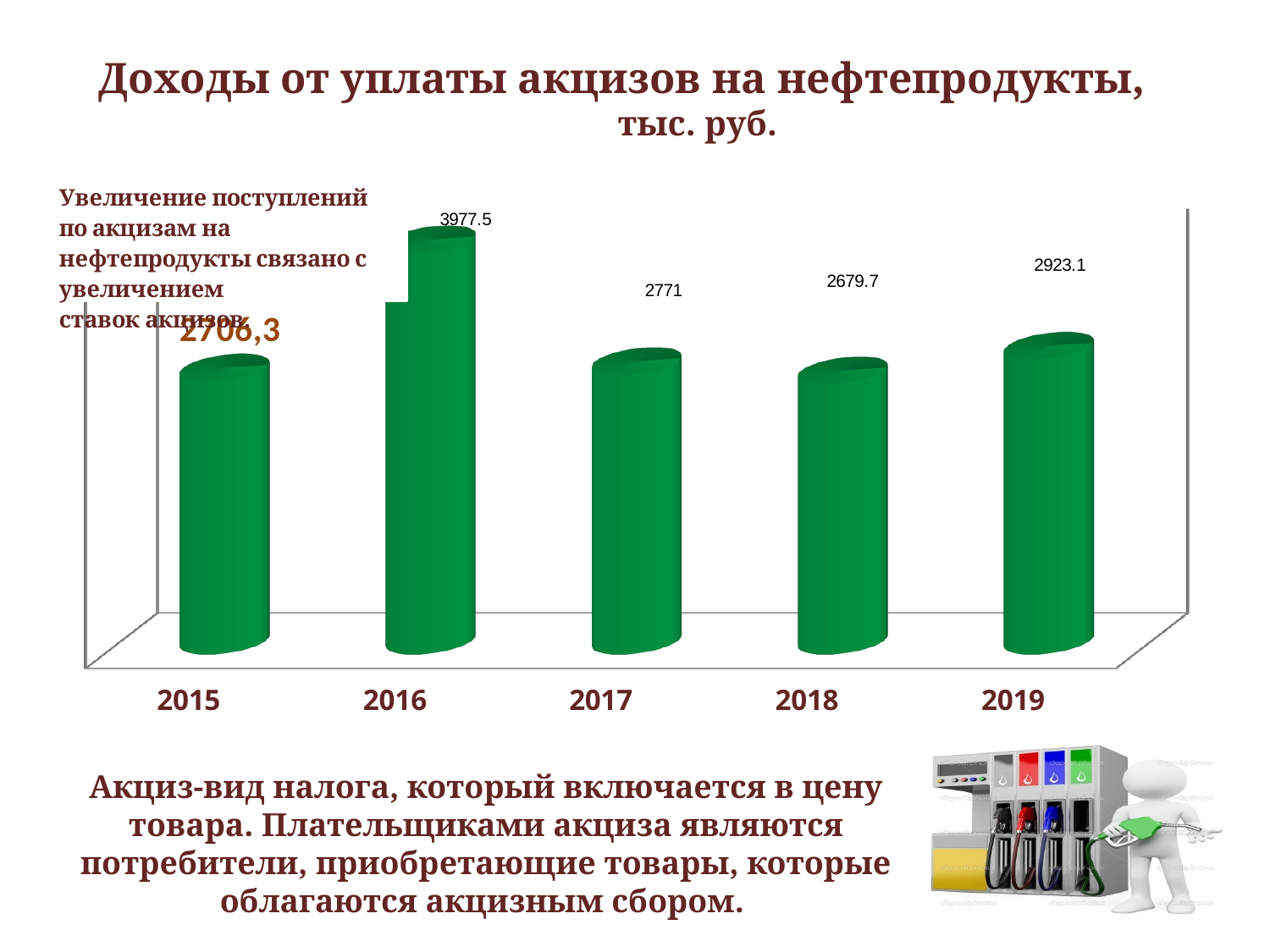
What is the value for 2018? 2679.7 What is the difference between the values for 2016 and 2017? 1206.5 Do the values rise or fall from 2016 to 2018? fall How many years are shown on the x axis? 5 What is the value for 2017? 2771 Which year has the highest value? 2016 What is the value for 2016? 3977.5 Which is larger, the value for 2019 or the value for 2017? 2019 What kind of chart is shown on the slide? bar chart What is the value for 2019? 2923.1 Which year has the lowest value? 2018 What is the difference between the values for 2019 and 2018? 243.4